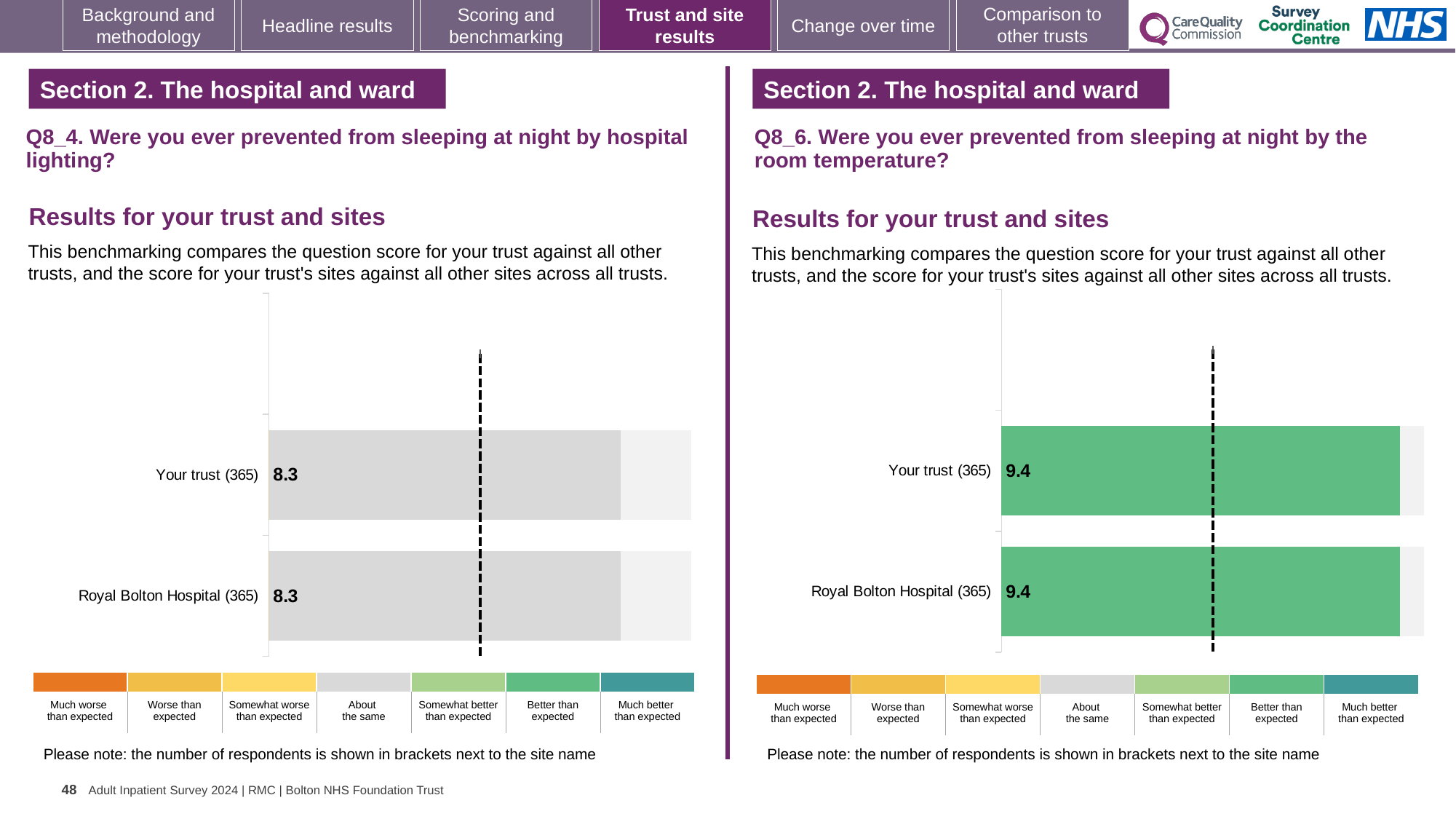
How many bars are plotted in the Q8_6 room temperature chart? 2 In the Q8_6 room temperature chart, what is the score for Your trust (365)? 9.4 In the Q8_4 hospital lighting chart, what is the score for Your trust (365)? 8.3 What type of chart is used for the Q8_6 room temperature results? Bar chart What type of chart is used for the Q8_4 hospital lighting results? Bar chart In the Q8_4 hospital lighting chart, which benchmark category does the grey colour of the bars correspond to in the legend? About the same In the Q8_6 room temperature chart, what is the difference between the Your trust score and the Royal Bolton Hospital score? 0.0 In the Q8_4 hospital lighting chart, what is the score for Royal Bolton Hospital (365)? 8.3 How many bars are plotted in the Q8_4 hospital lighting chart? 2 In the Q8_6 room temperature chart, what is the score for Royal Bolton Hospital (365)? 9.4 In the Q8_4 hospital lighting chart, what is the difference between the Your trust score and the Royal Bolton Hospital score? 0.0 In the Q8_6 room temperature chart, which benchmark category does the green colour of the bars correspond to in the legend? Better than expected